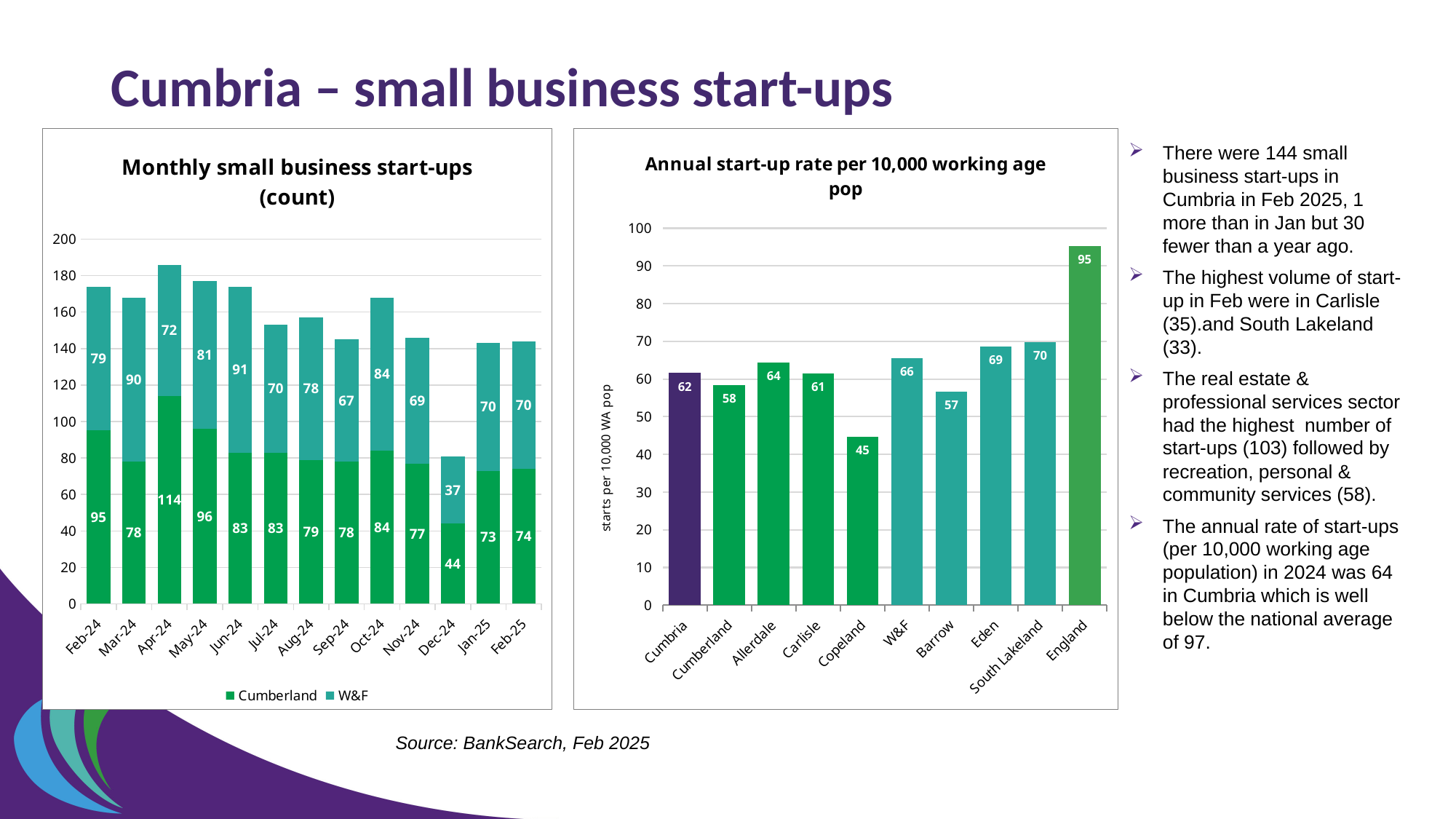
In the 'Monthly small business start-ups (count)' chart, how many months are shown on the x axis? 13 In the 'Monthly small business start-ups (count)' chart, what is the W&F value for Jun-24? 91 In the 'Monthly small business start-ups (count)' chart, how many series does the legend list? 2 In the 'Annual start-up rate per 10,000 working age pop' chart, which is larger, the value for Eden or the value for Barrow? Eden In the 'Annual start-up rate per 10,000 working age pop' chart, which category has the highest value? England In the 'Monthly small business start-ups (count)' chart, what is the Cumberland value for Apr-24? 114 In the 'Monthly small business start-ups (count)' chart, what is the total of the stacked bar for Feb-25? 144 In the 'Monthly small business start-ups (count)' chart, what is the difference between the Cumberland and W&F values for Dec-24? 7 In the 'Monthly small business start-ups (count)' chart, which month has the lowest Cumberland value? Dec-24 In the 'Annual start-up rate per 10,000 working age pop' chart, what is the difference between the values for England and Cumbria? 33 In the 'Annual start-up rate per 10,000 working age pop' chart, what is the value for Copeland? 45 What kind of chart is the 'Annual start-up rate per 10,000 working age pop' chart? Bar chart